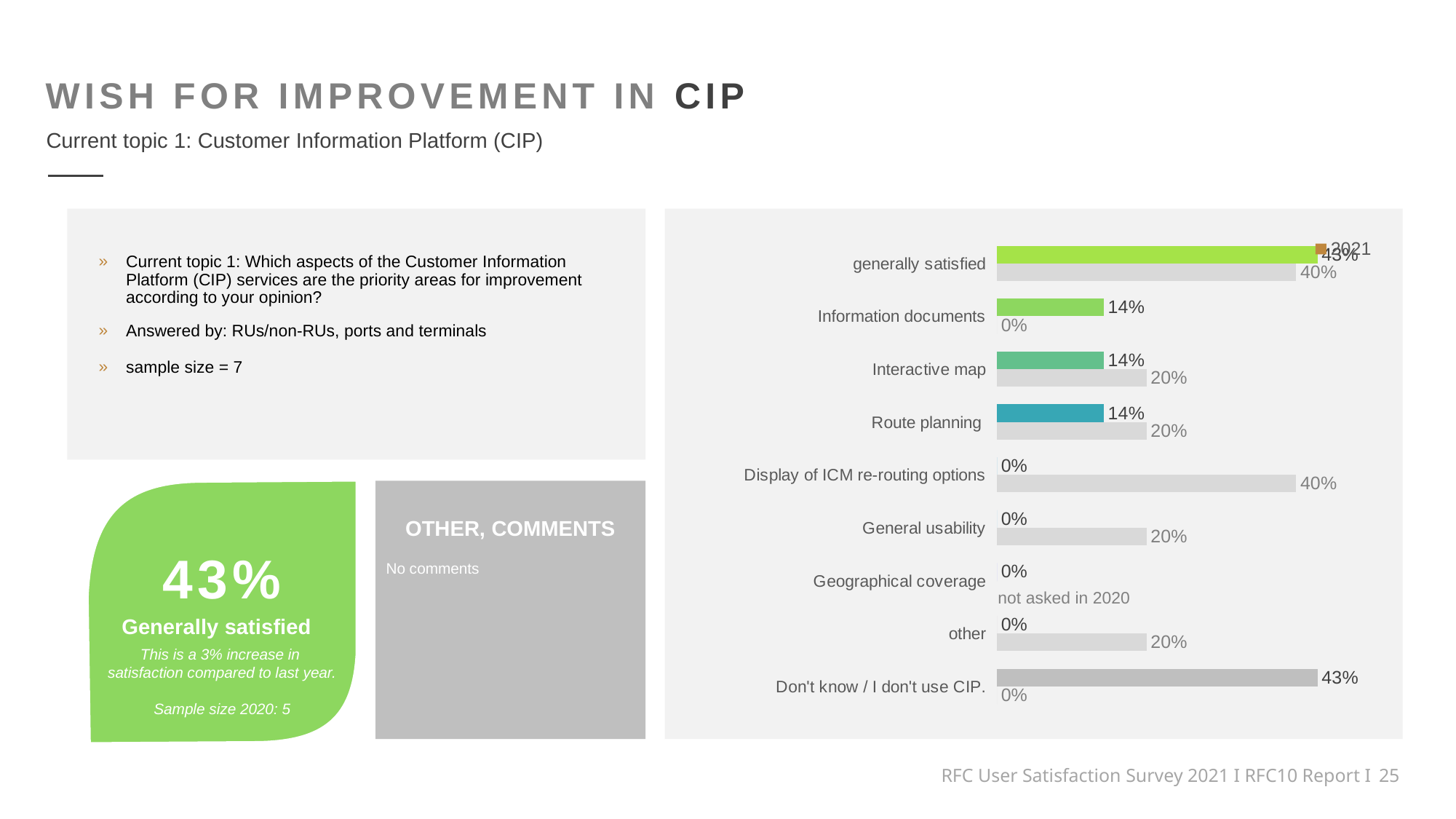
What is the 2021 value for General usability? 0% What is shown for Geographical coverage in 2020? not asked in 2020 How many categories are listed on the chart? 9 What is the 2020 value for generally satisfied? 40% What is the 2021 value for Information documents? 14% What is the 2020 value for Display of ICM re-routing options? 40% What kind of chart is shown on the slide? bar chart What is the 2021 value for Don't know / I don't use CIP? 43% Which is larger for Route planning, the 2021 value or the 2020 value? 2020 What is the 2020 value for other? 20% What is the difference between the 2020 and 2021 values for Interactive map? 6% What is the difference between the 2021 and 2020 values for generally satisfied? 3%